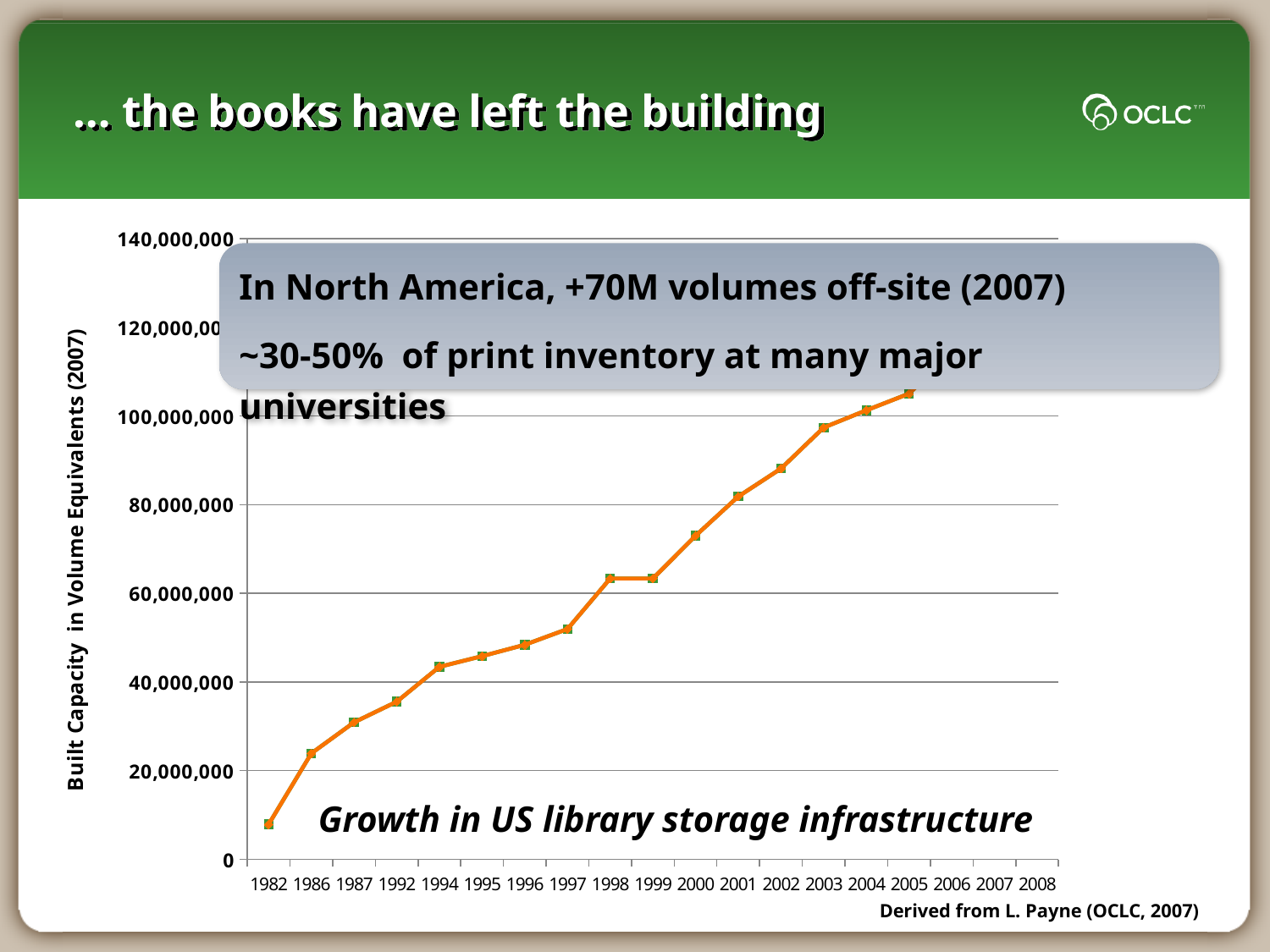
Which year has the larger value, 1997 or 2002? 2002 Which year shown on the chart has the lowest value? 1982 Is the value for 2000 greater or less than 80,000,000? less Is the value for 2005 greater or less than 100,000,000? greater Is the value for 1986 greater or less than 20,000,000? greater Do the values in the chart generally rise or fall from 1982 to 2005? rise How many year labels are shown along the x axis of the chart? 19 What kind of chart is shown on the slide? line chart What is the label on the vertical axis of the chart? Built Capacity in Volume Equivalents (2007) What is the title of the chart? Growth in US library storage infrastructure